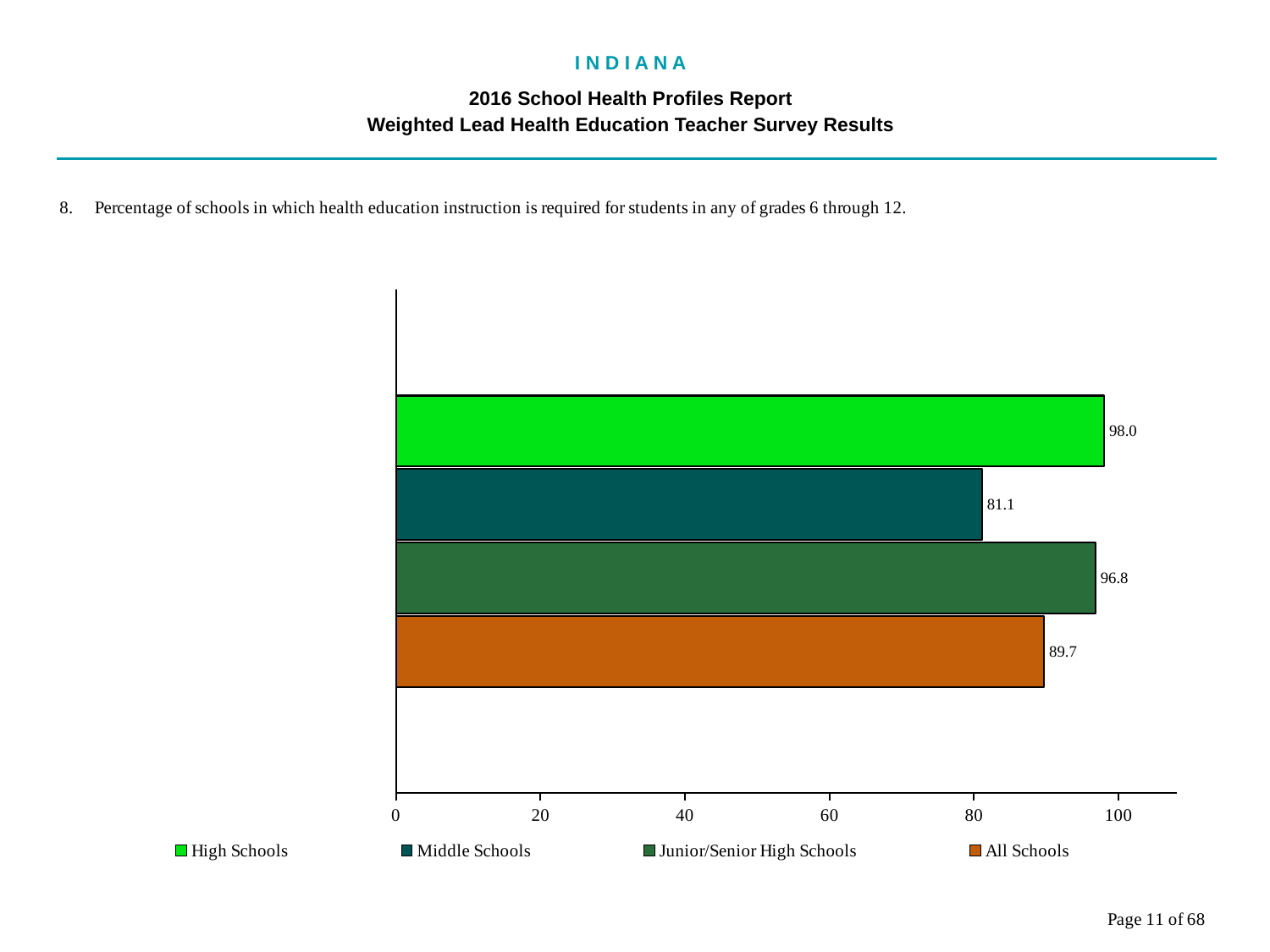
Is the value for Middle Schools greater or less than 80? greater What kind of chart is shown on the slide? Bar chart Which school type has the lowest value? Middle Schools What is the value for Junior/Senior High Schools? 96.8 What is the value for Middle Schools? 81.1 What is the value for All Schools? 89.7 What is the difference between the High Schools value and the Middle Schools value? 16.9 How many series does the legend list? 4 What is the difference between the Junior/Senior High Schools value and the All Schools value? 7.1 What is the value for High Schools? 98.0 Which school type has the highest value? High Schools Which is larger, the value for Middle Schools or the value for All Schools? All Schools